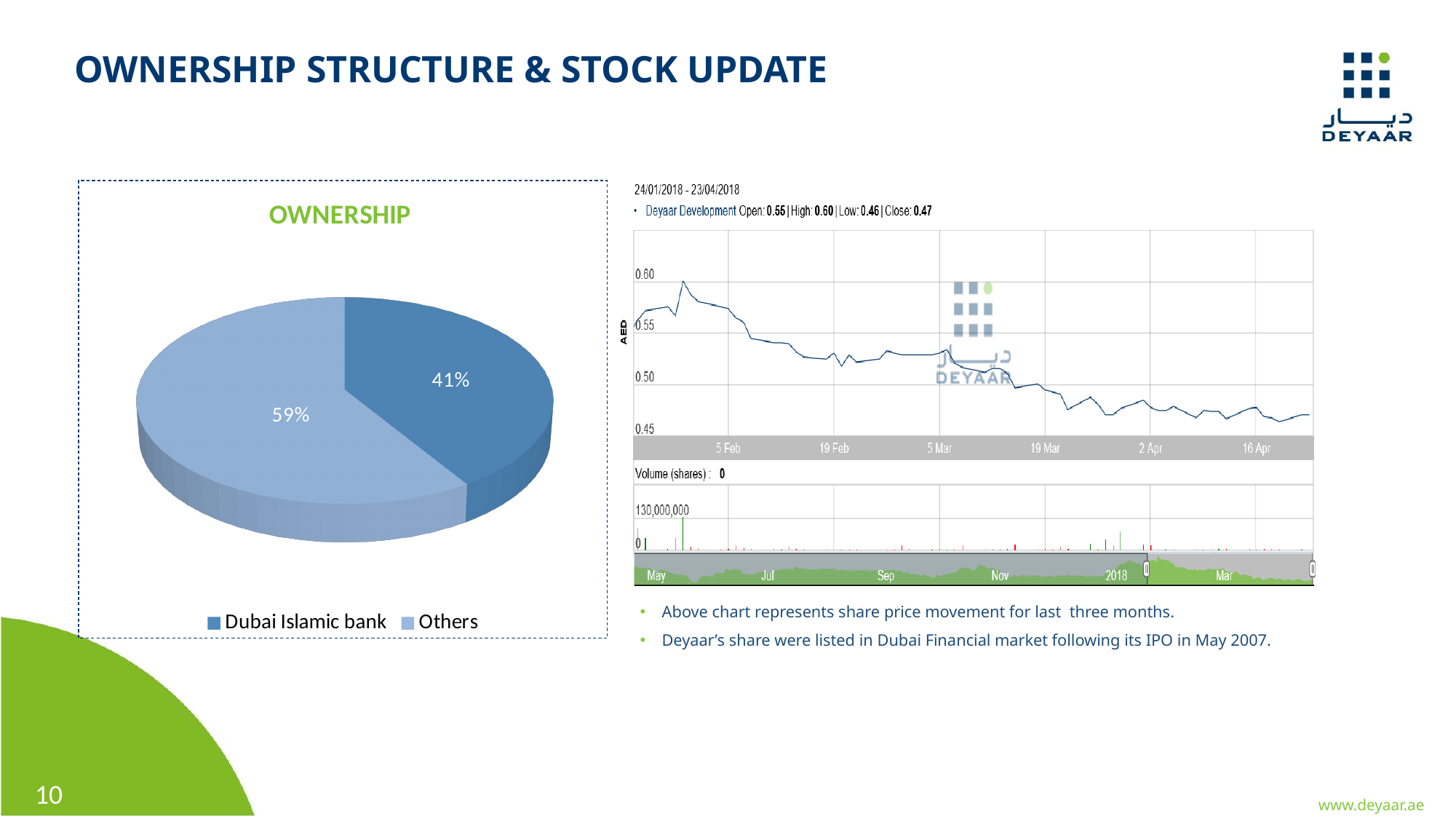
In the share price chart on the right, what is the Close value shown for Deyaar Development? 0.47 What kind of chart is the OWNERSHIP chart on the left of the slide? Pie chart In the share price chart on the right, does the share price generally rise or fall from 5 Feb to 16 Apr? Fall In the OWNERSHIP pie chart, which slice is the largest? Others In the OWNERSHIP pie chart, which entries does the legend list? Dubai Islamic bank, Others In the OWNERSHIP pie chart, how many slices are there? 2 What kind of chart is the share price chart on the right of the slide? Line chart In the OWNERSHIP pie chart, what share is labelled Others? 59% In the OWNERSHIP pie chart, what share is held by Dubai Islamic bank? 41% In the OWNERSHIP pie chart, which slice is the smallest? Dubai Islamic bank In the share price chart on the right, what is the High value shown for Deyaar Development? 0.60 In the OWNERSHIP pie chart, what is the difference in percentage points between the Others slice and the Dubai Islamic bank slice? 18